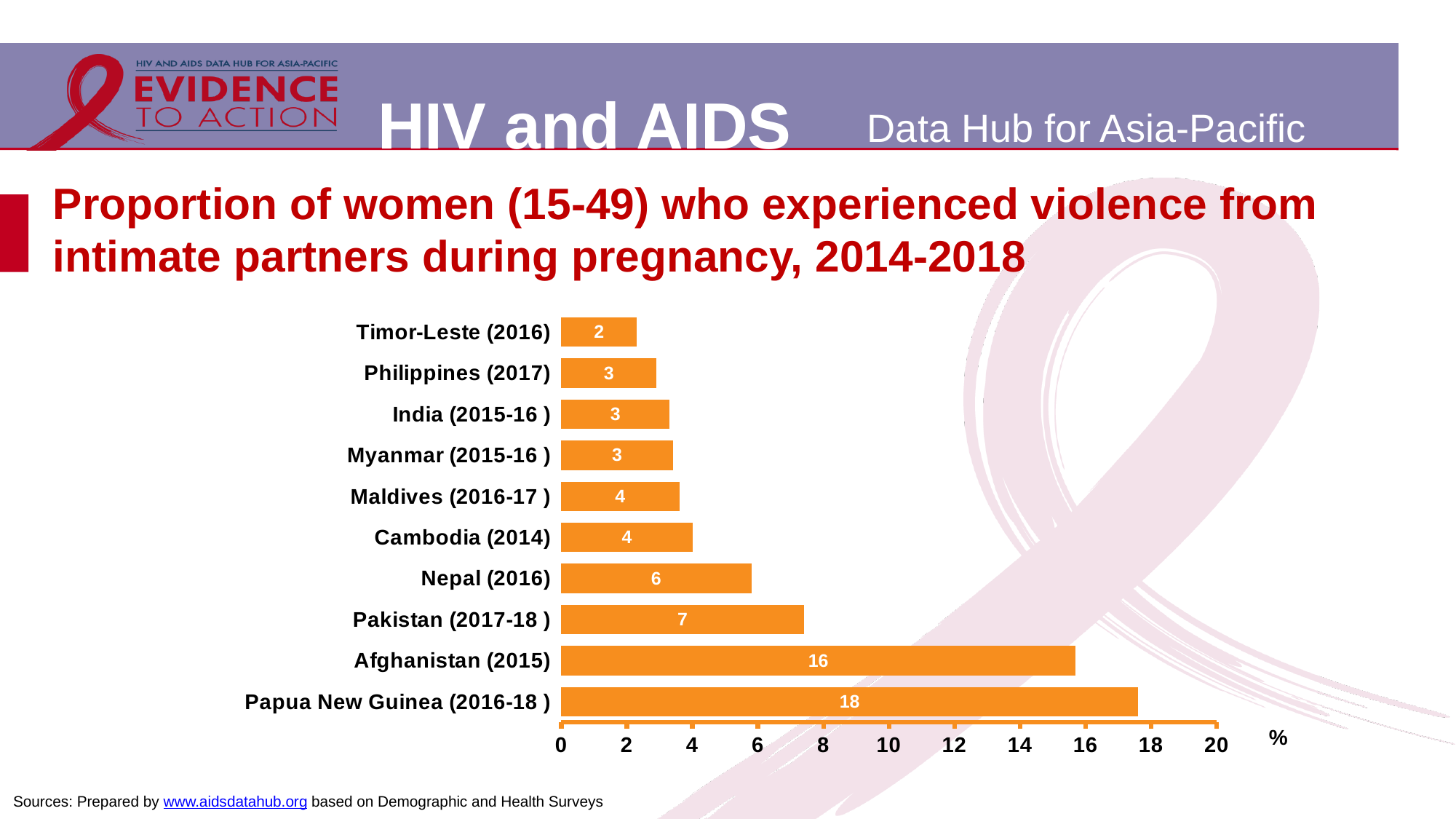
What is the difference between the values for Pakistan (2017-18) and Nepal (2016)? 1 What is the value for Afghanistan (2015)? 16 What is the value for Papua New Guinea (2016-18)? 18 How many countries are shown in the chart? 10 What is the difference between the values for Papua New Guinea (2016-18) and Afghanistan (2015)? 2 Which country has the lowest proportion of women who experienced violence from intimate partners during pregnancy? Timor-Leste (2016) Which country has the highest proportion of women who experienced violence from intimate partners during pregnancy? Papua New Guinea (2016-18) What kind of chart is shown on the slide? Bar chart What is the value for Timor-Leste (2016)? 2 Is the value for Afghanistan (2015) greater or less than 10? greater What is the value for Nepal (2016)? 6 Which is larger, the value for Pakistan (2017-18) or the value for Cambodia (2014)? Pakistan (2017-18)